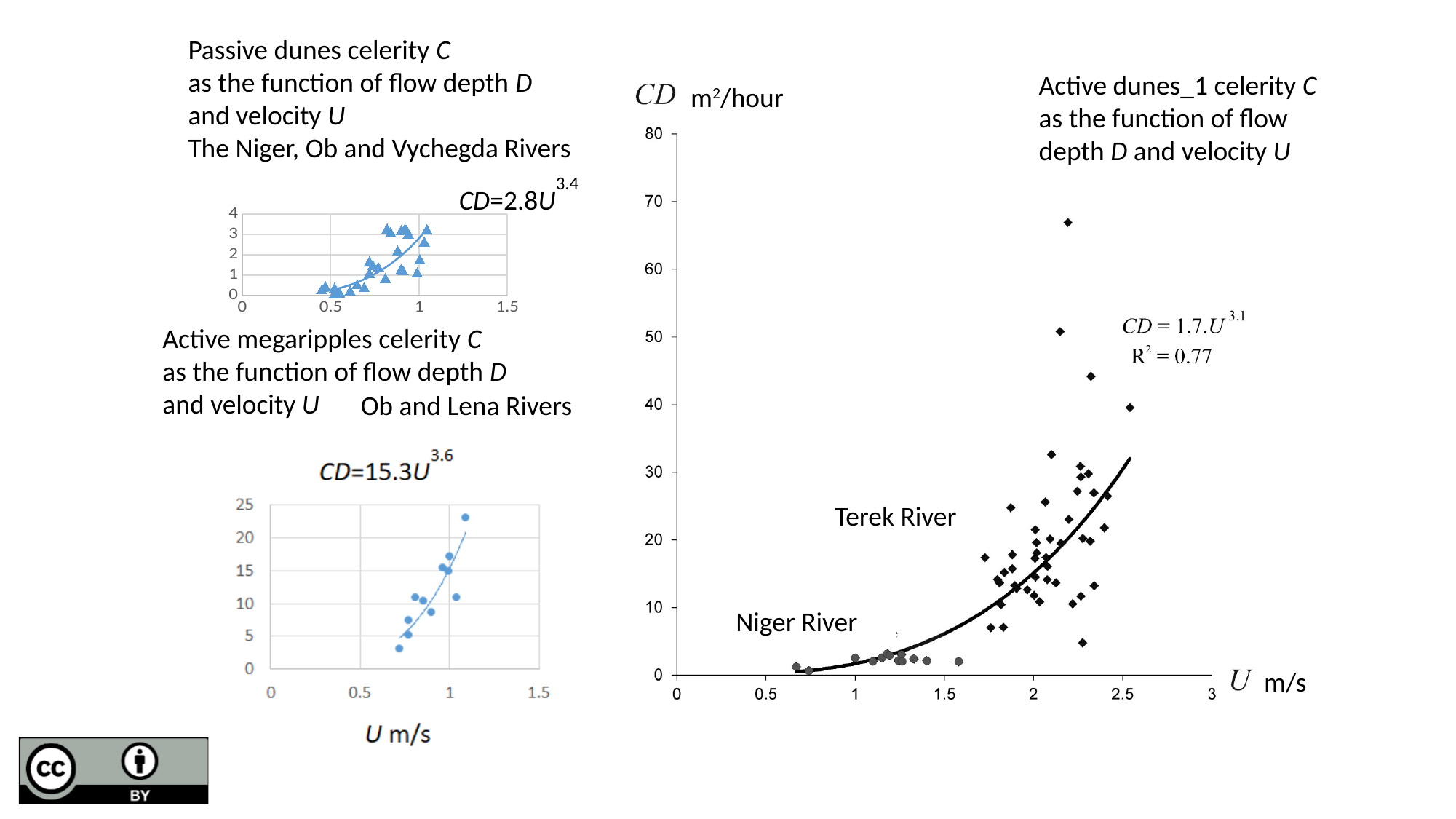
What kind of chart is the large chart on the right of the slide (Active dunes_1 celerity)? scatter chart In the right-hand chart (Active dunes_1 celerity), what is the fitted equation shown next to the data? CD = 1.7.U^3.1 In the bottom-left chart (Active megaripples celerity), do the values rise or fall as U increases along the x axis? rise In the right-hand chart (Active dunes_1 celerity), what R² value is printed on the chart? R² = 0.77 In the right-hand chart (Active dunes_1 celerity), what is the maximum value shown on the vertical axis? 80 In the top-left chart (Passive dunes celerity), is the highest plotted point greater or less than 2? greater In the right-hand chart (Active dunes_1 celerity), do the CD values generally rise or fall as U increases along the x axis? rise In the right-hand chart (Active dunes_1 celerity), are the Niger River points greater or less than 10 m²/hour? less In the right-hand chart (Active dunes_1 celerity), is the highest plotted point greater or less than 60 m²/hour? greater